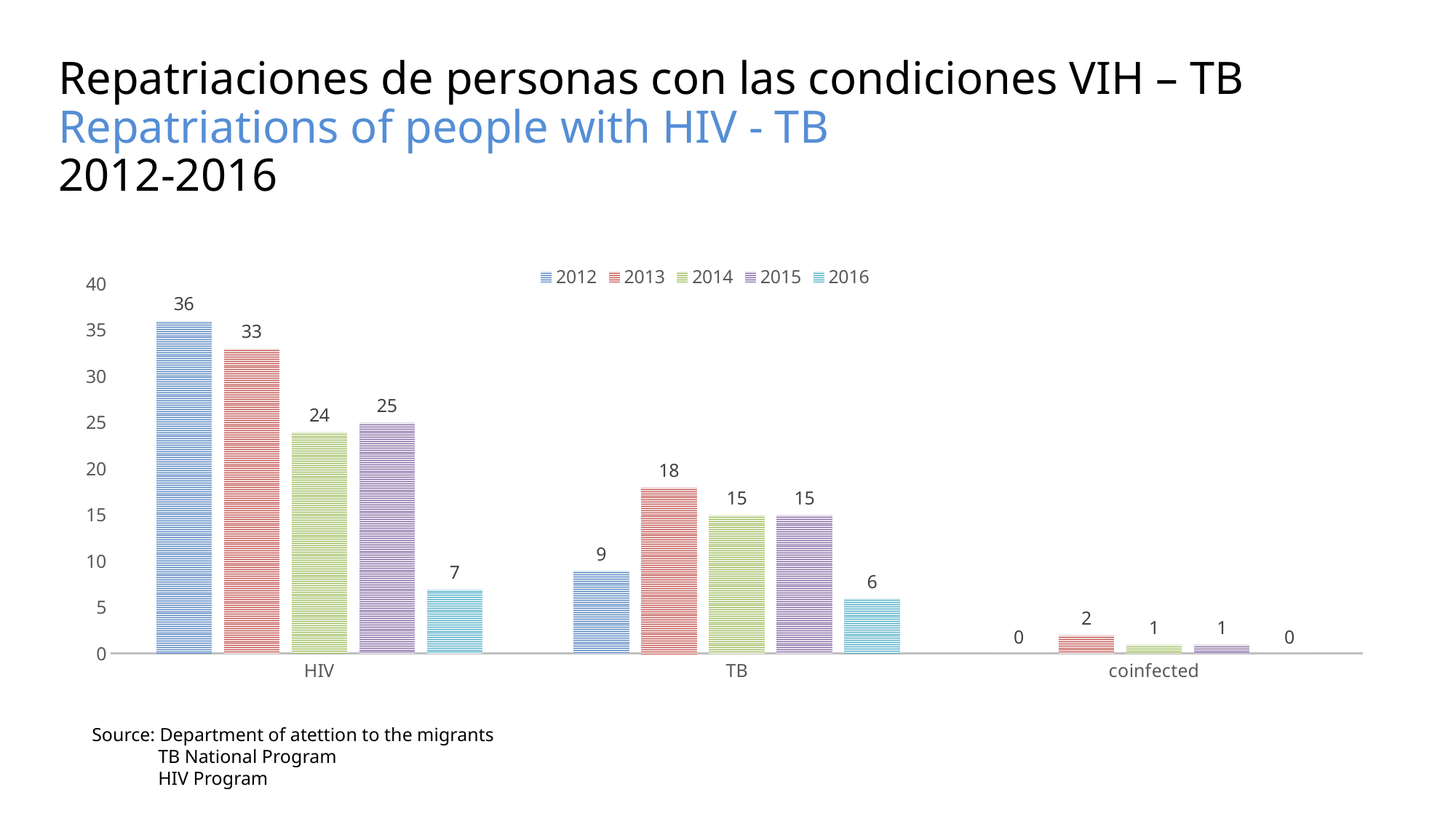
How many series does the legend list? 5 What kind of chart is shown on the slide? bar chart What is the difference between the HIV values for 2012 and 2013? 3 What is the value for HIV in 2016? 7 How many categories are shown on the x axis? 3 Do the HIV values rise or fall from 2012 to 2014? fall What is the value for coinfected in 2013? 2 Which year has the lowest value for TB? 2016 What is the value for HIV in 2012? 36 Which is larger, the HIV value for 2014 or for 2015? 2015 What is the value for TB in 2013? 18 Which year has the highest value for HIV? 2012